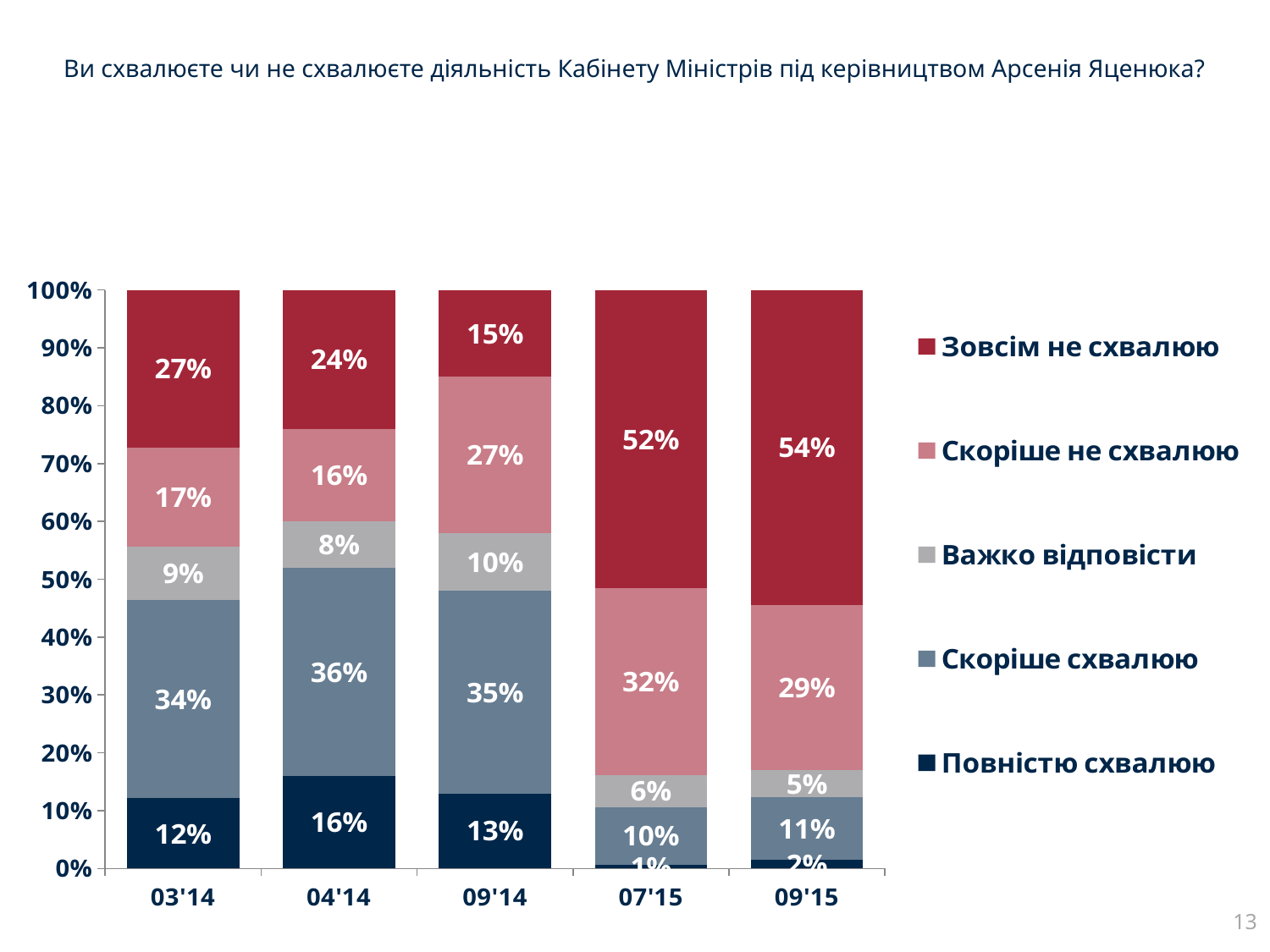
In which period is the "Зовсім не схвалюю" share the highest? 09'15 What kind of chart is shown on the slide? Stacked bar chart In which period is the "Повністю схвалюю" share the lowest? 07'15 Which legend entry is shown in the darkest blue colour? Повністю схвалюю What is the value for "Важко відповісти" in 09'14? 10% Does the "Зовсім не схвалюю" share rise or fall from 09'14 to 09'15? Rise What is the value for "Скоріше схвалюю" in 04'14? 36% What percentage of respondents answered "Зовсім не схвалюю" in 09'15? 54% Which is larger: "Скоріше схвалюю" in 09'14 or "Скоріше схвалюю" in 07'15? 09'14 What is the difference between the "Скоріше не схвалюю" values in 07'15 and 09'15? 3% How many series does the legend list? 5 How many time periods are shown on the x axis? 5